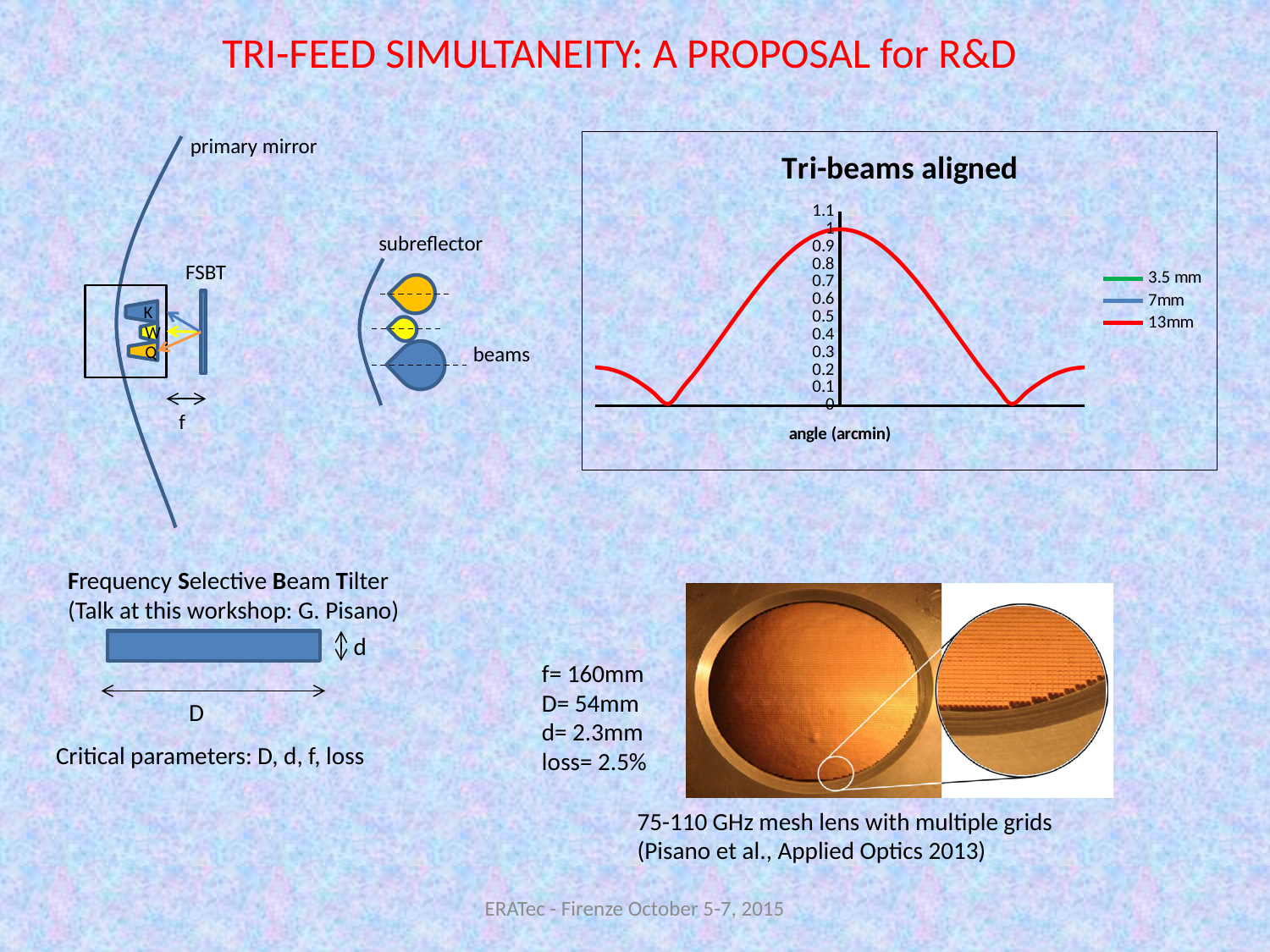
In the 'Tri-beams aligned' chart, is the peak value of the 13mm curve greater or less than 0.9? greater How many series does the legend of the 'Tri-beams aligned' chart list? 3 What is the highest tick value shown on the y axis of the 'Tri-beams aligned' chart? 1.1 What kind of chart is shown in the 'Tri-beams aligned' panel? line chart What is the title of the chart on the slide? Tri-beams aligned Which legend entry in the 'Tri-beams aligned' chart corresponds to the red curve? 13mm What is the label of the x axis of the 'Tri-beams aligned' chart? angle (arcmin) In the 'Tri-beams aligned' chart, does the 13mm curve rise or fall as the angle moves from the central peak toward the first null on the right? fall In the 'Tri-beams aligned' chart, is the value of the 13mm curve at its nulls (the dips either side of the peak) greater or less than 0.1? less